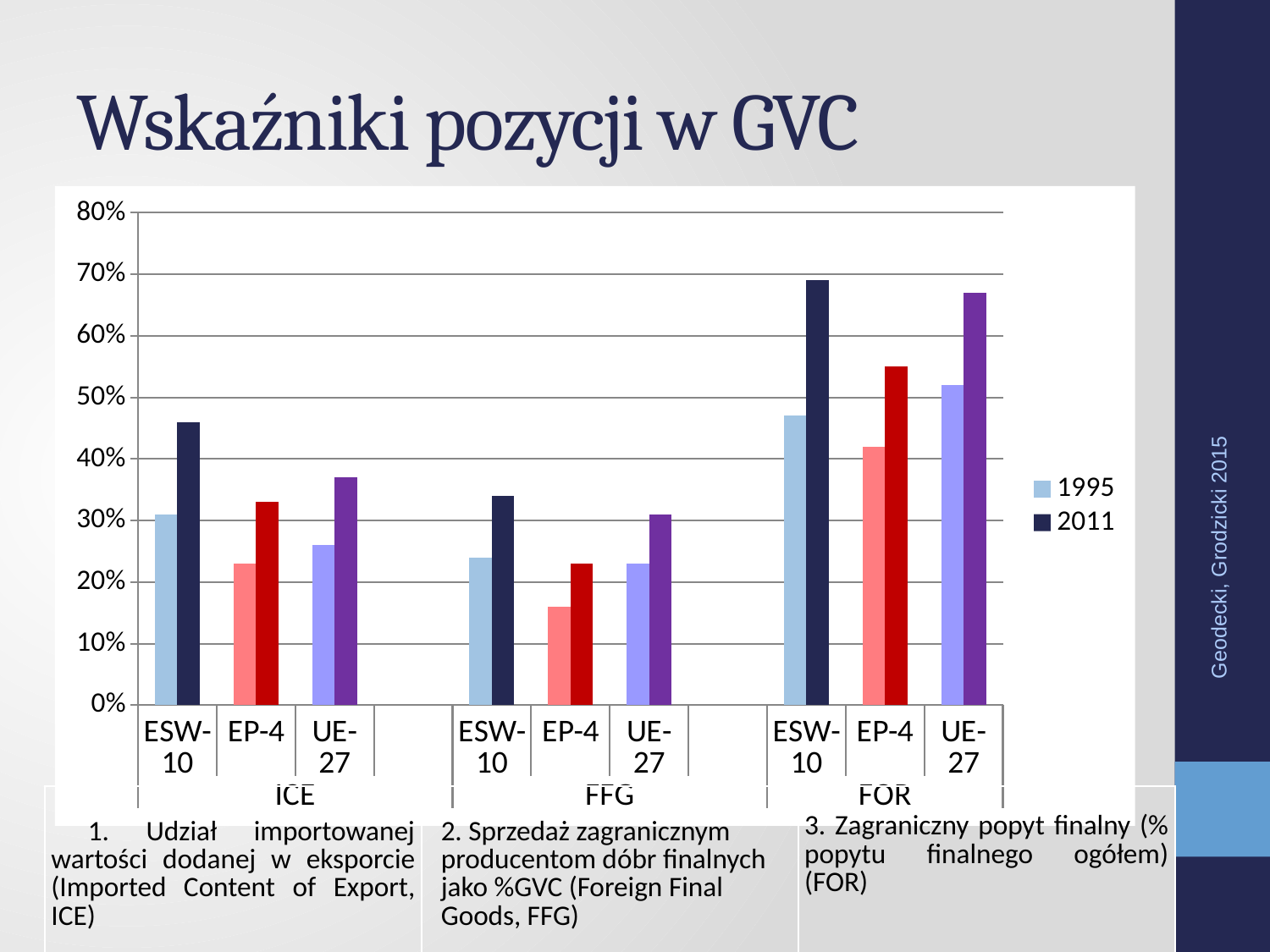
Is the 2011 value for EP-4 in the FOR group greater or less than 50%? greater What kind of chart is shown on the slide? bar chart How many series does the legend list? 2 Which bar is the highest in the whole chart? ESW-10, 2011, in the FOR group Is the 2011 value for ESW-10 in the FOR group greater or less than 60%? greater Is the 1995 value for EP-4 in the FFG group greater or less than 20%? less In the ICE group, which has the larger 2011 value, ESW-10 or UE-27? ESW-10 In the FOR group, which has the larger 1995 value, EP-4 or UE-27? UE-27 How many indicator groups (ICE, FFG, FOR) are shown along the x axis? 3 Which two years are listed in the legend? 1995 and 2011 Which 1995 bar is the lowest in the whole chart? EP-4 in the FFG group